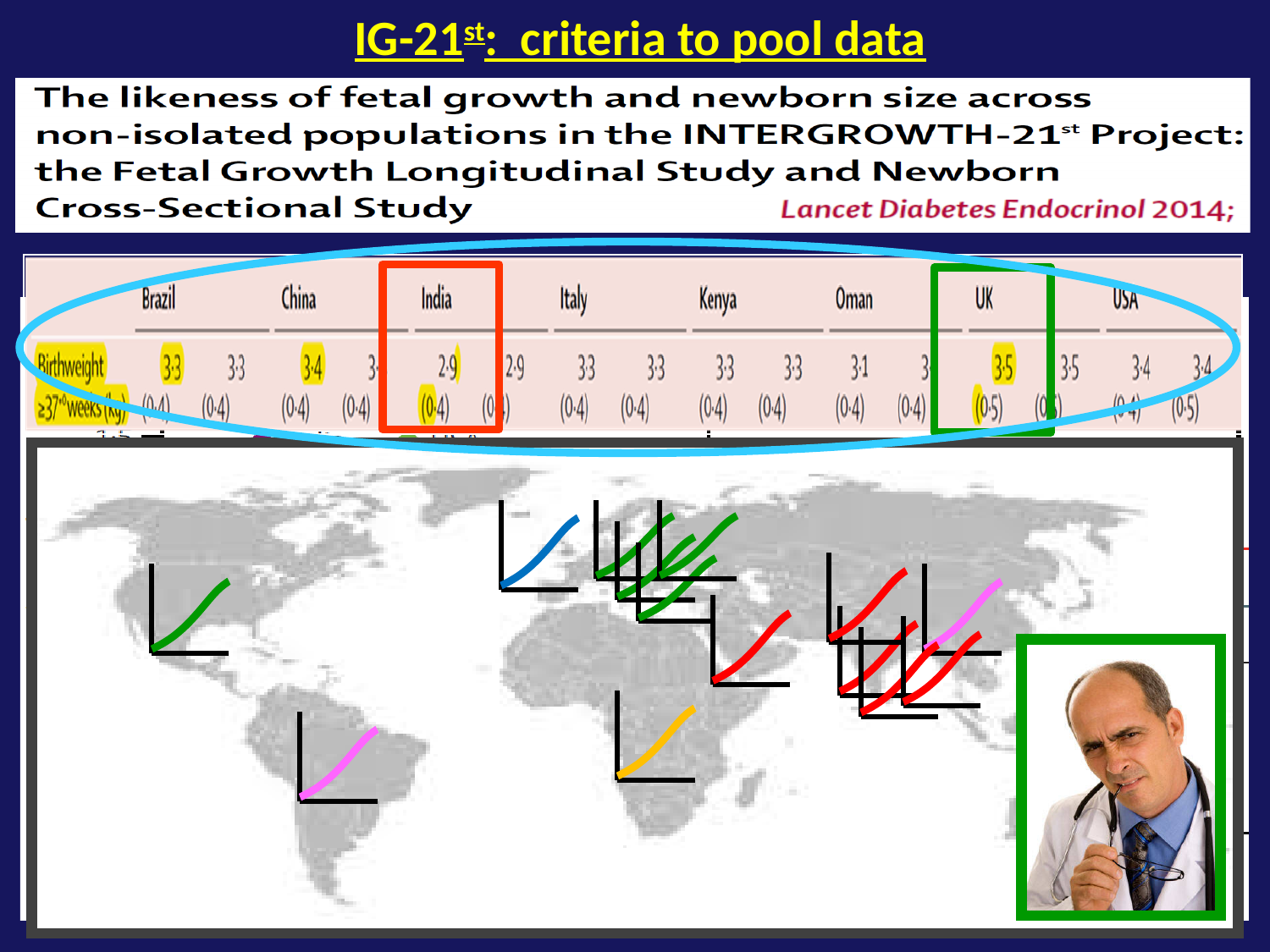
In the birthweight table, is the highlighted birthweight value larger for Kenya or for India? Kenya In the birthweight table, which country's column is outlined with a green box? UK In the birthweight table, which country has the lowest highlighted birthweight value? India In the birthweight table, what is the highlighted birthweight (≥37 weeks, kg) value for the UK? 3·5 How many countries are listed as column headers in the birthweight table? 8 In the birthweight table, what is the difference between the highlighted birthweight values for the UK and India? 0·6 In the birthweight table, which country's column is outlined with a red box? India In the birthweight table, which country has the highest highlighted birthweight value? UK In the birthweight table, what is the highlighted birthweight (≥37 weeks, kg) value for Oman? 3·1 In the birthweight table, what is the highlighted birthweight (≥37 weeks, kg) value for China? 3·4 In the birthweight table, what is the highlighted birthweight (≥37 weeks, kg) value for Brazil? 3·3 In the birthweight table, what is the highlighted birthweight (≥37 weeks, kg) value for India? 2·9